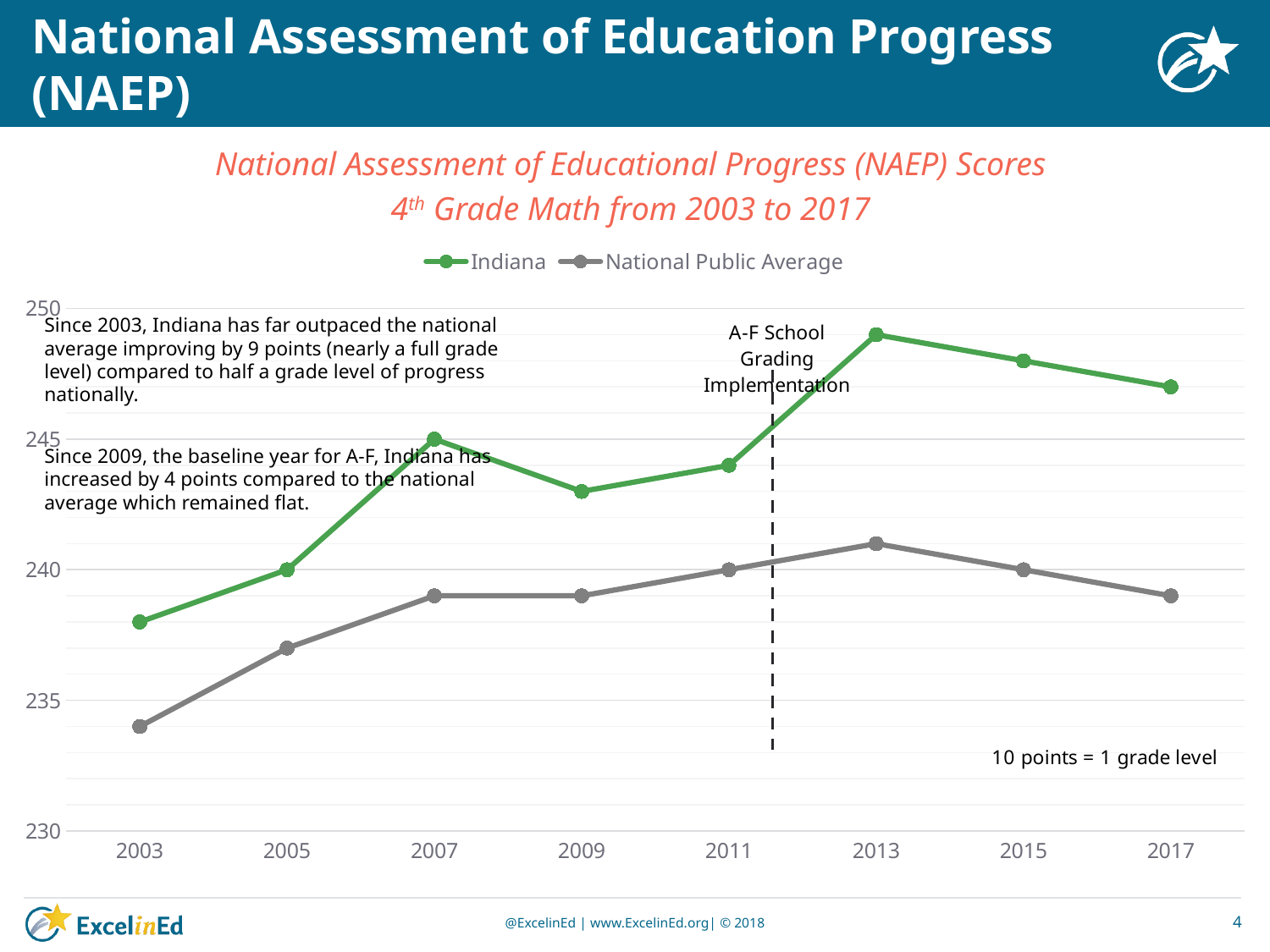
Does the National Public Average rise or fall from 2013 to 2017? fall How many series does the legend list? 2 What is the Indiana value for 2007? 245 Is the Indiana value for 2013 greater or less than 245? greater In 2017, which series has the higher value, Indiana or National Public Average? Indiana What kind of chart is shown on the slide? line chart In which year does the Indiana series reach its highest value? 2013 In which year is the National Public Average at its lowest? 2003 How many years are plotted along the x axis? 8 In which year is the Indiana series at its lowest? 2003 According to the note on the chart, how many points equal one grade level? 10 points Is the National Public Average value for 2003 greater or less than 235? less